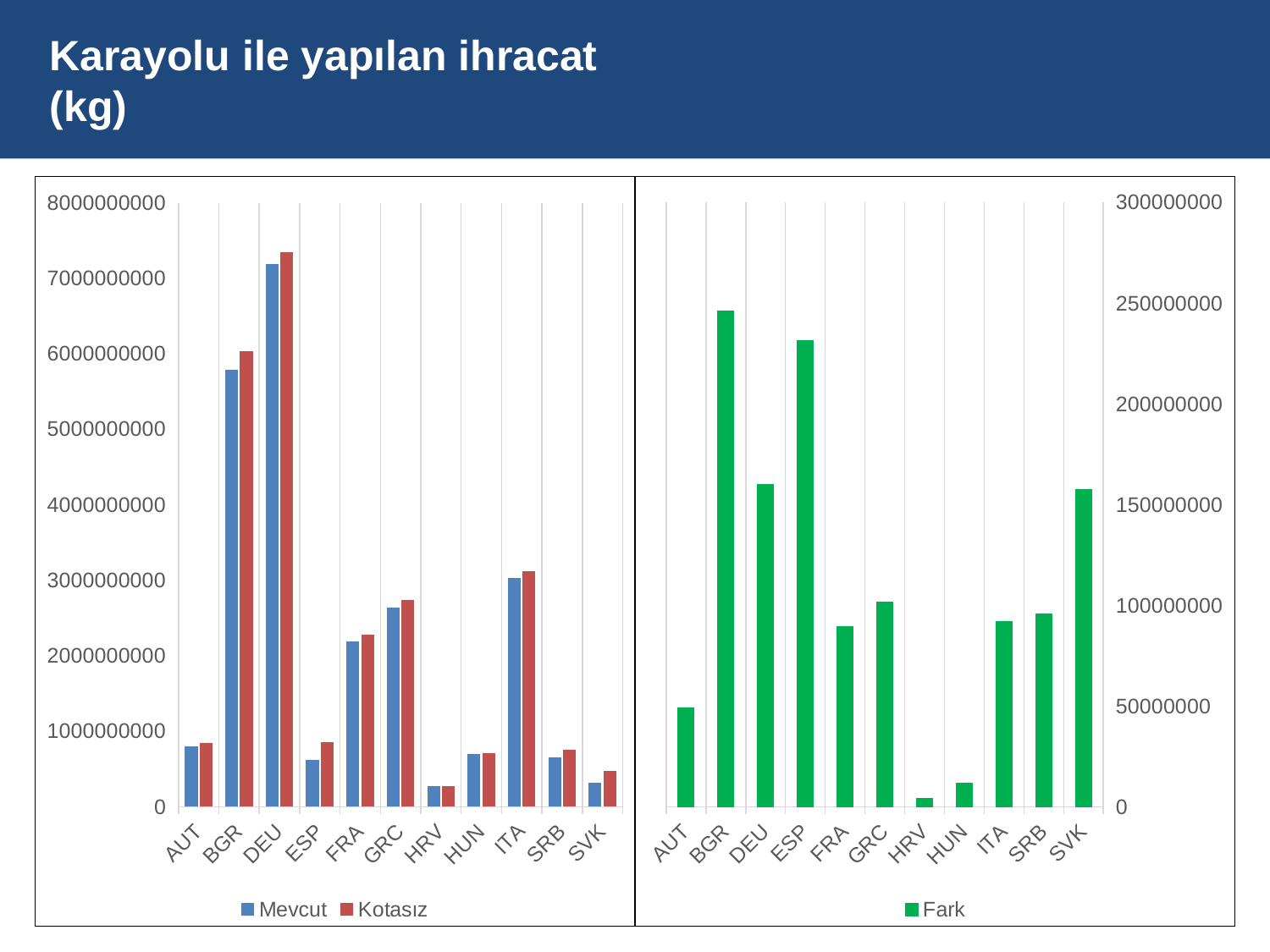
How many series does the legend of the left chart list? 2 In the right chart, is the Fark value for ESP greater or less than 200000000? greater In the left chart, which category has the lowest Kotasız value? HRV In the left chart, is the Mevcut value for BGR greater or less than 5000000000? greater In the left chart, which category has the highest Mevcut value? DEU What type of chart is the right chart? bar chart In the left chart, is the Mevcut value for ESP greater or less than 1000000000? less How many categories are shown on the x axis of the right chart? 11 In the left chart, which is larger for BGR, the Mevcut value or the Kotasız value? Kotasız In the right chart, which category has the highest Fark value? BGR In the right chart, which category has the lowest Fark value? HRV In the right chart, which has the larger Fark value, GRC or FRA? GRC